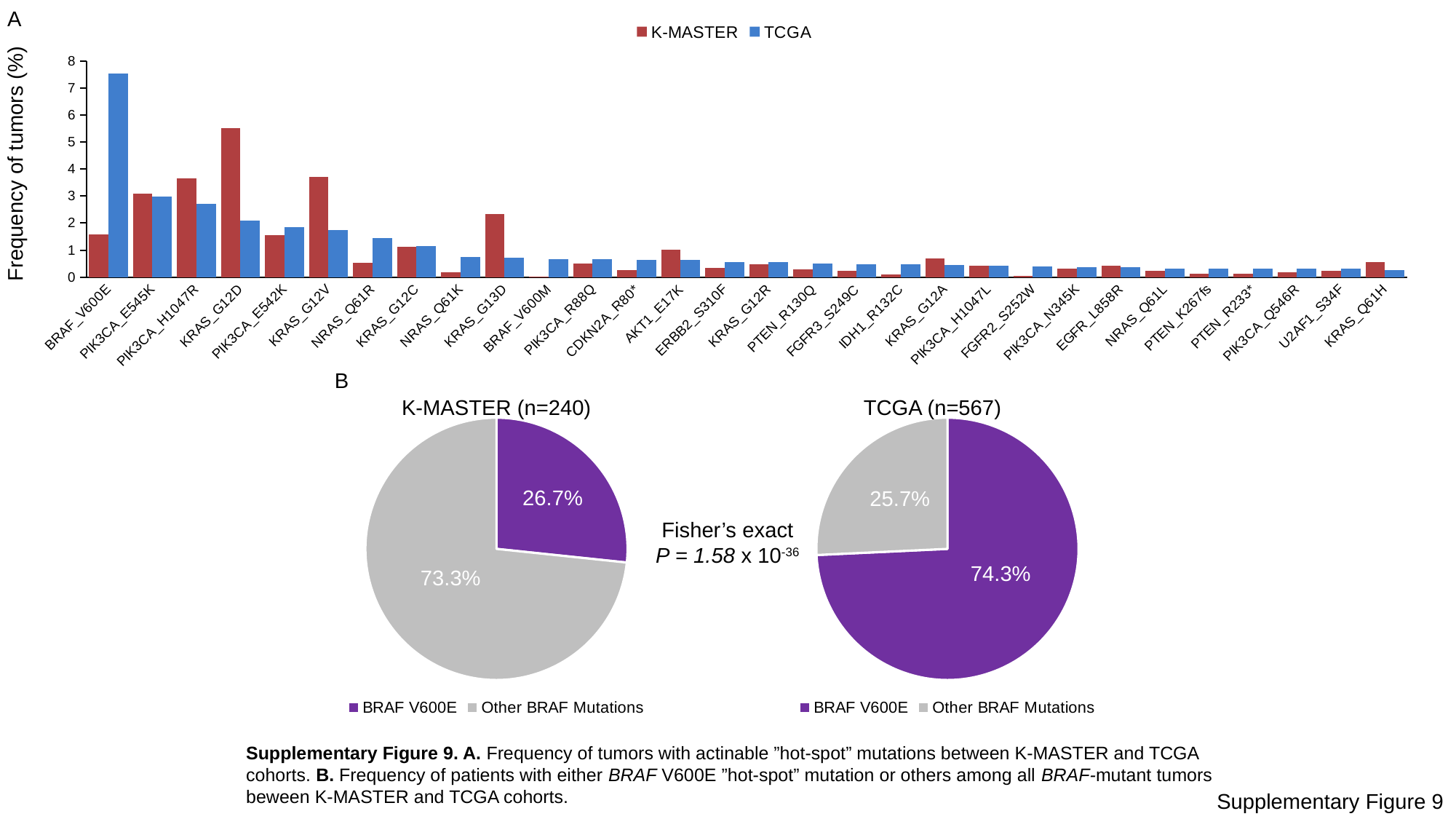
In chart A, is the K-MASTER value for KRAS_G12D greater or less than 5? greater In chart A, for BRAF_V600E, which cohort has the higher frequency, K-MASTER or TCGA? TCGA In chart A, how many series does the legend list? 2 In chart A, for KRAS_G12V, which cohort has the higher frequency, K-MASTER or TCGA? K-MASTER In the TCGA (n=567) pie chart, what share is Other BRAF Mutations? 25.7% In chart A, how many mutation categories are shown on the x axis? 30 In chart A, which mutation has the highest TCGA frequency? BRAF_V600E In chart A, which mutation has the highest K-MASTER frequency? KRAS_G12D In the K-MASTER (n=240) pie chart, what share is BRAF V600E? 26.7% Comparing the two pie charts, how many percentage points higher is the BRAF V600E share in TCGA than in K-MASTER? 47.6 In chart A, is the TCGA value for BRAF_V600E greater or less than 6? greater In chart A (K-MASTER vs TCGA frequency of tumors), what kind of chart is it? Bar chart